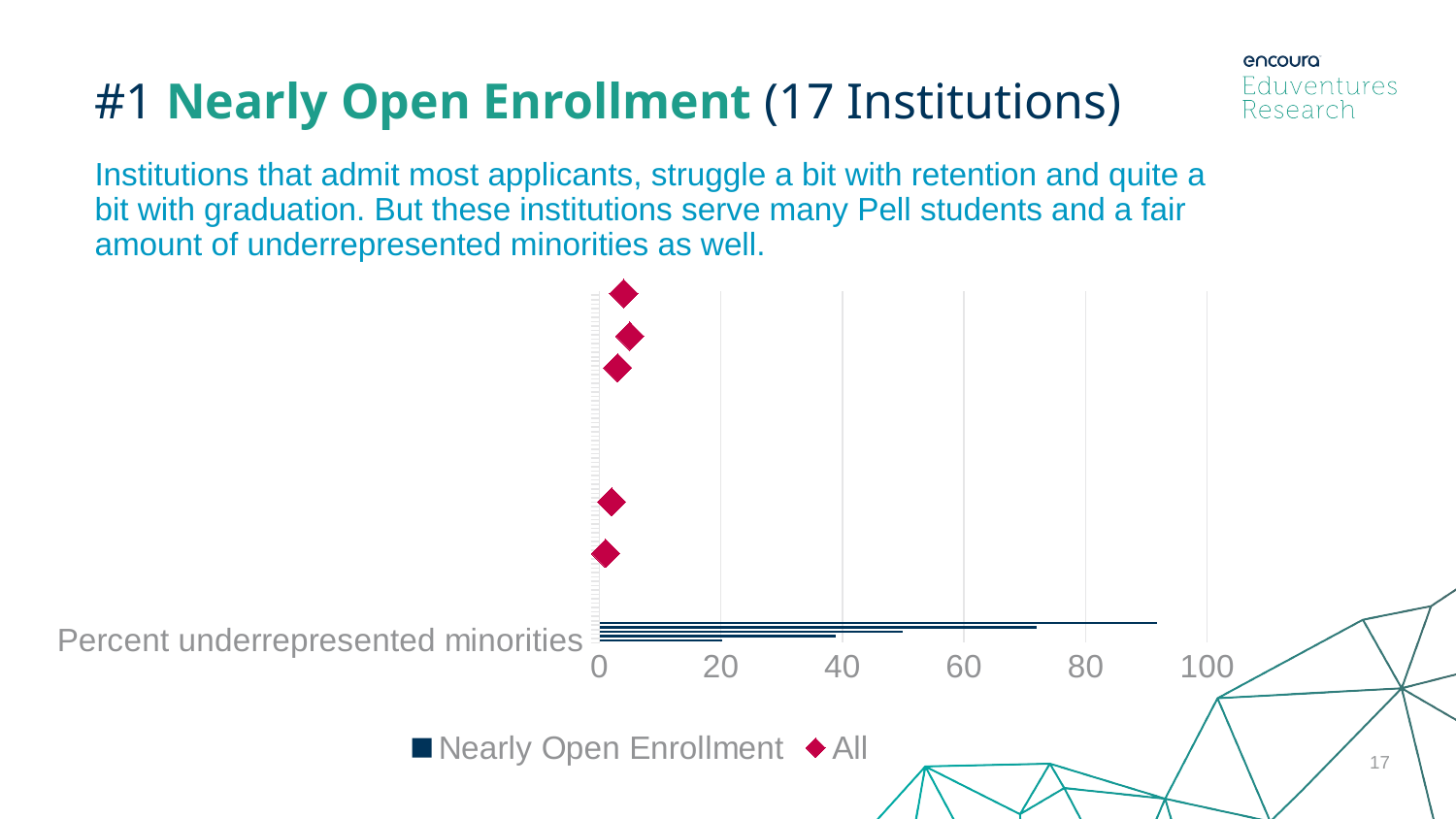
Are the 'All' diamond markers plotted at values greater or less than 20? less How many 'All' diamond markers are plotted on the chart? 5 What shape marks the 'All' series on the chart? Diamond What is the highest value shown on the chart's horizontal axis? 100 How many series does the chart legend list? 2 Is the longest Nearly Open Enrollment bar for Percent underrepresented minorities greater or less than 80? greater What are the two series named in the chart legend? Nearly Open Enrollment and All Are the Nearly Open Enrollment values drawn as horizontal or vertical bars? Horizontal Which series reaches the larger value on the horizontal axis, Nearly Open Enrollment or All? Nearly Open Enrollment Is the shortest Nearly Open Enrollment bar for Percent underrepresented minorities greater or less than 40? less What category label is shown on the chart's vertical axis? Percent underrepresented minorities